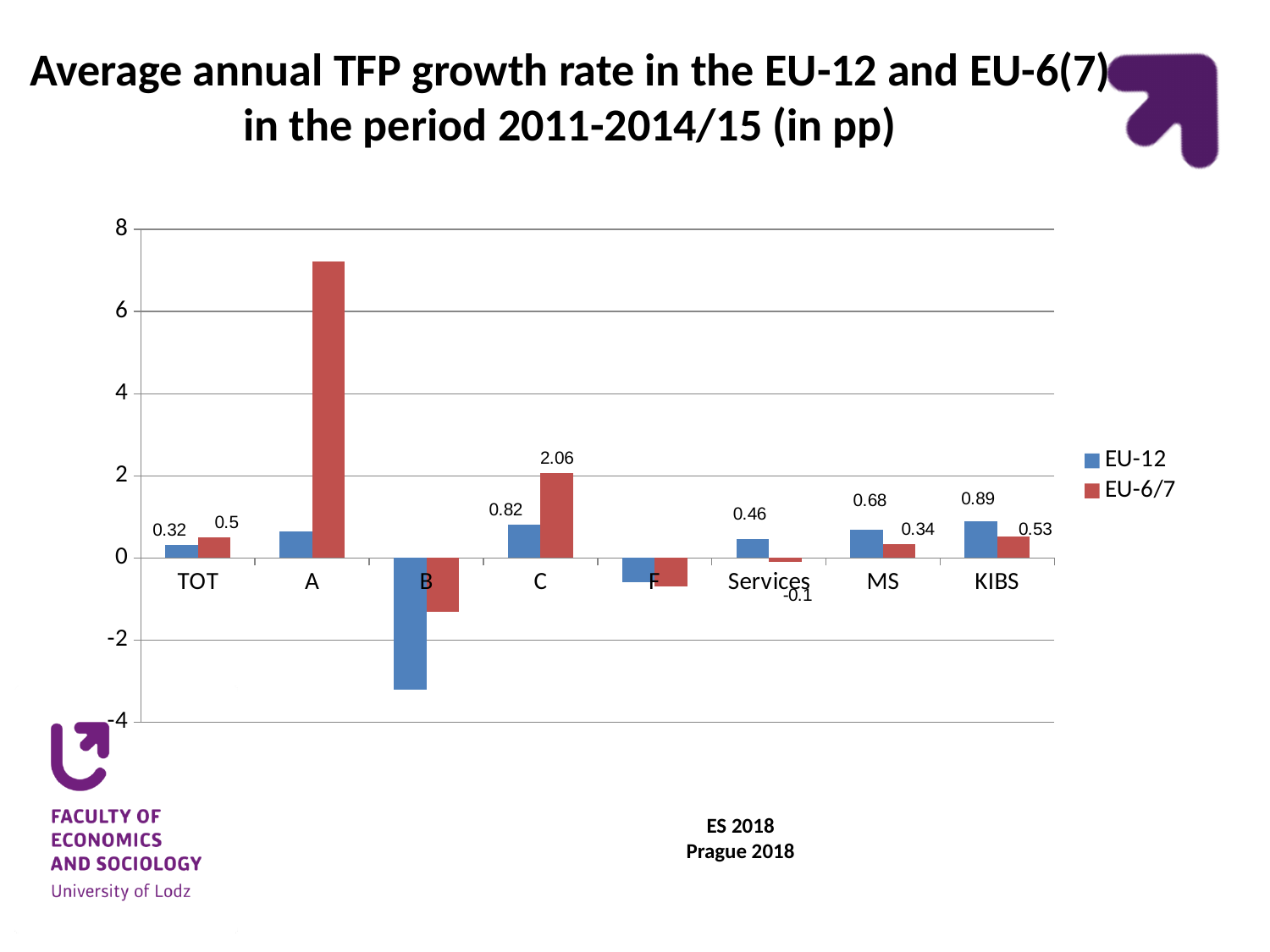
What kind of chart is shown on the slide? bar chart What is the EU-6/7 value for Services? -0.1 Which category has the highest EU-6/7 value? A Which category has the lowest EU-12 value? B What is the EU-12 value for TOT? 0.32 What is the EU-6/7 value for C? 2.06 What is the EU-12 value for KIBS? 0.89 For category C, how much larger is the EU-6/7 value than the EU-12 value? 1.24 How many categories are shown on the x axis? 8 Is the EU-6/7 value for A greater or less than 6? greater For MS, which series has the larger value, EU-12 or EU-6/7? EU-12 How many series does the legend list? 2